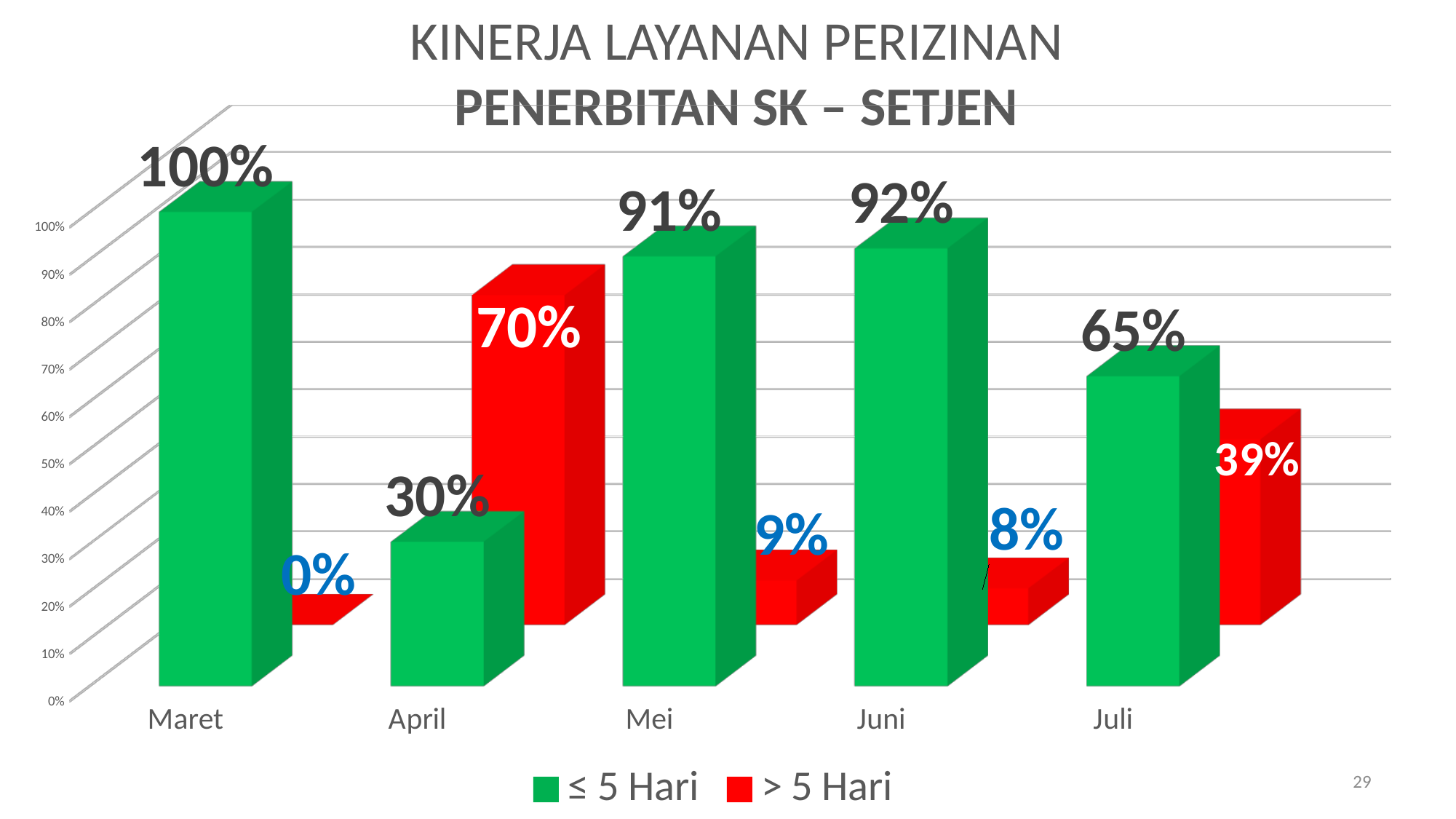
Which month has the highest value for "> 5 Hari"? April What is the value for "> 5 Hari" in Juni? 8% What is the value for "≤ 5 Hari" in Juli? 65% What is the value for "> 5 Hari" in April? 70% Which colour represents the "> 5 Hari" series? Red What is the value for "≤ 5 Hari" in Maret? 100% How many months are shown on the x axis? 5 Which month has the lowest value for "≤ 5 Hari"? April How many series does the legend list? 2 What is the difference between the "≤ 5 Hari" values for Mei and Juli? 26% What kind of chart is shown on the slide? Bar chart Which is larger in Juli: the "≤ 5 Hari" value or the "> 5 Hari" value? ≤ 5 Hari